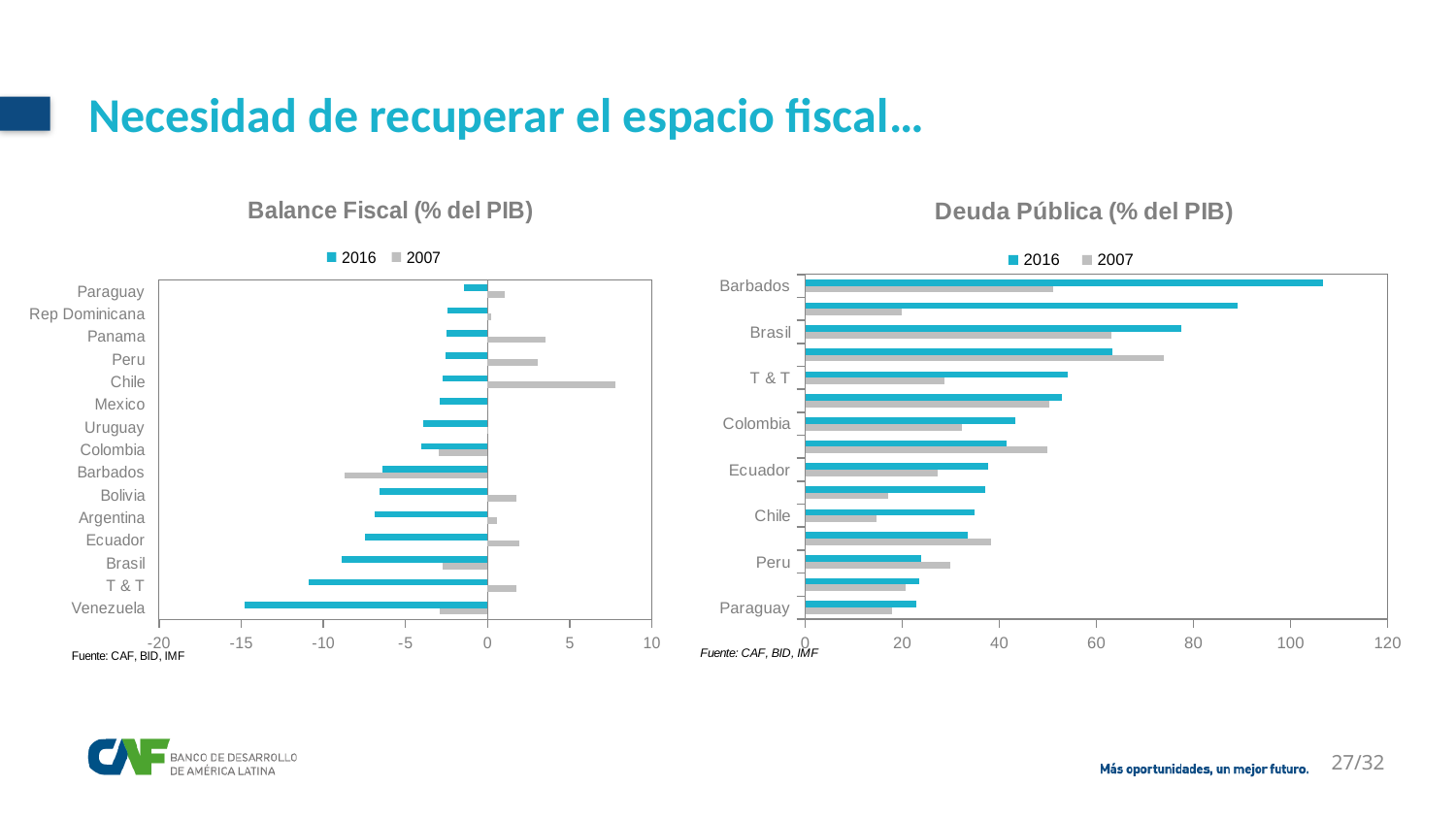
How many series does the legend of the 'Balance Fiscal (% del PIB)' chart list? 2 In the 'Balance Fiscal (% del PIB)' chart, is the 2016 value for Barbados greater or less than -5? less In the 'Deuda Pública (% del PIB)' chart, is the 2016 value for Barbados greater or less than 100? greater In the 'Balance Fiscal (% del PIB)' chart, which country has the lowest 2016 value? Venezuela In the 'Deuda Pública (% del PIB)' chart, which is larger for Brasil, the 2016 value or the 2007 value? 2016 In the 'Deuda Pública (% del PIB)' chart, which country has the highest 2016 value? Barbados In the 'Deuda Pública (% del PIB)' chart, which is larger for Peru, the 2016 value or the 2007 value? 2007 How many countries are shown on the 'Balance Fiscal (% del PIB)' chart? 15 In the 'Deuda Pública (% del PIB)' chart, which colour represents the 2007 series? grey What kind of chart is the 'Balance Fiscal (% del PIB)' chart? bar chart In the 'Balance Fiscal (% del PIB)' chart, is the 2016 value for Venezuela greater or less than -10? less In the 'Balance Fiscal (% del PIB)' chart, which country has the highest 2007 value? Chile